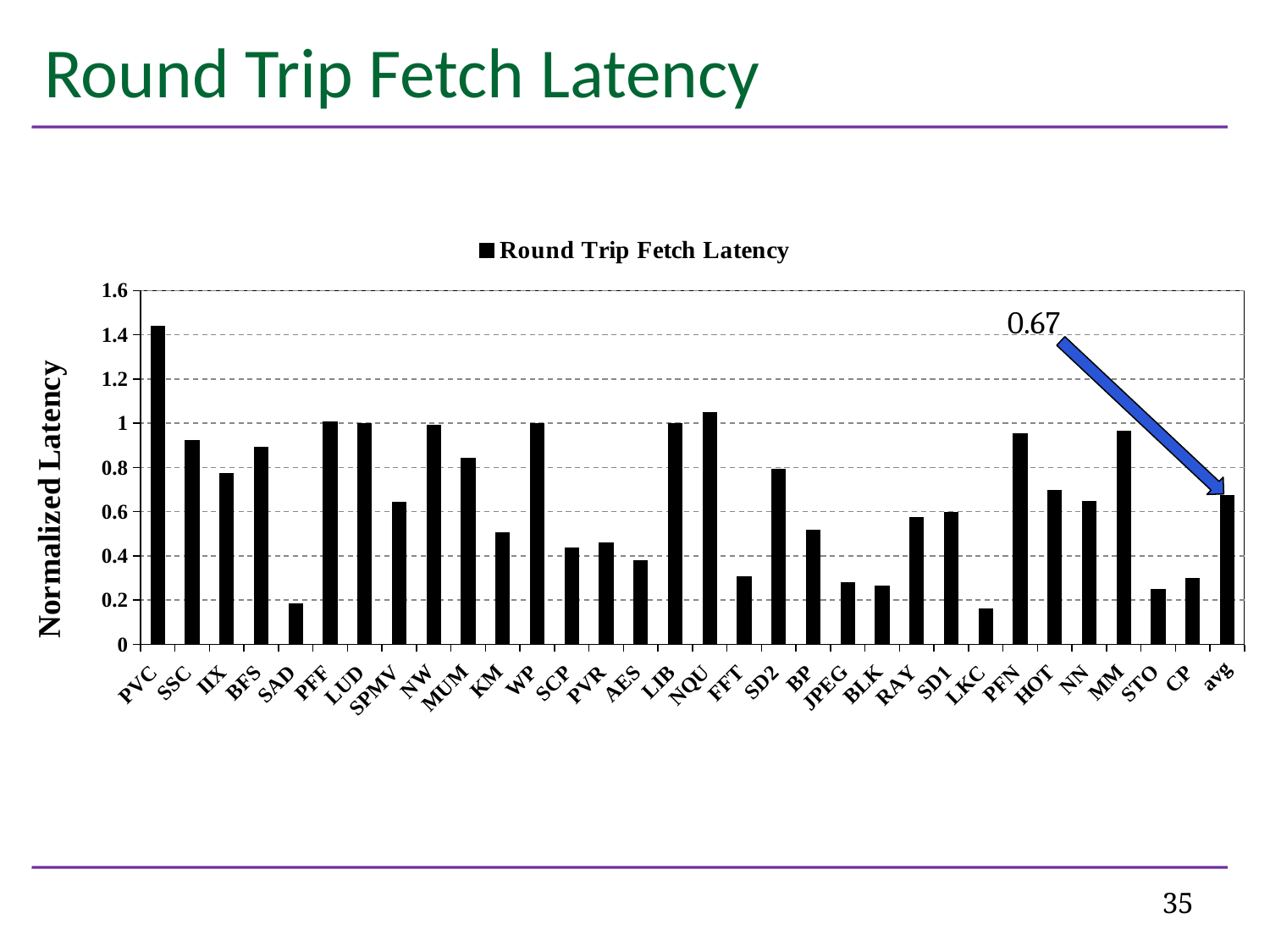
Is the value for SPMV greater or less than 0.8? less What is the label of the y axis? Normalized Latency Which has the larger value, HOT or LKC? HOT What type of chart is shown on the slide? bar chart Is the value for PVC greater or less than 1.2? greater Is the value for PFN greater or less than 0.8? greater What is the value for avg, as annotated on the chart? 0.67 Which category has the highest Round Trip Fetch Latency? PVC How many categories are shown on the x axis? 32 How many series does the legend list? 1 Which has the larger value, SAD or PFF? PFF